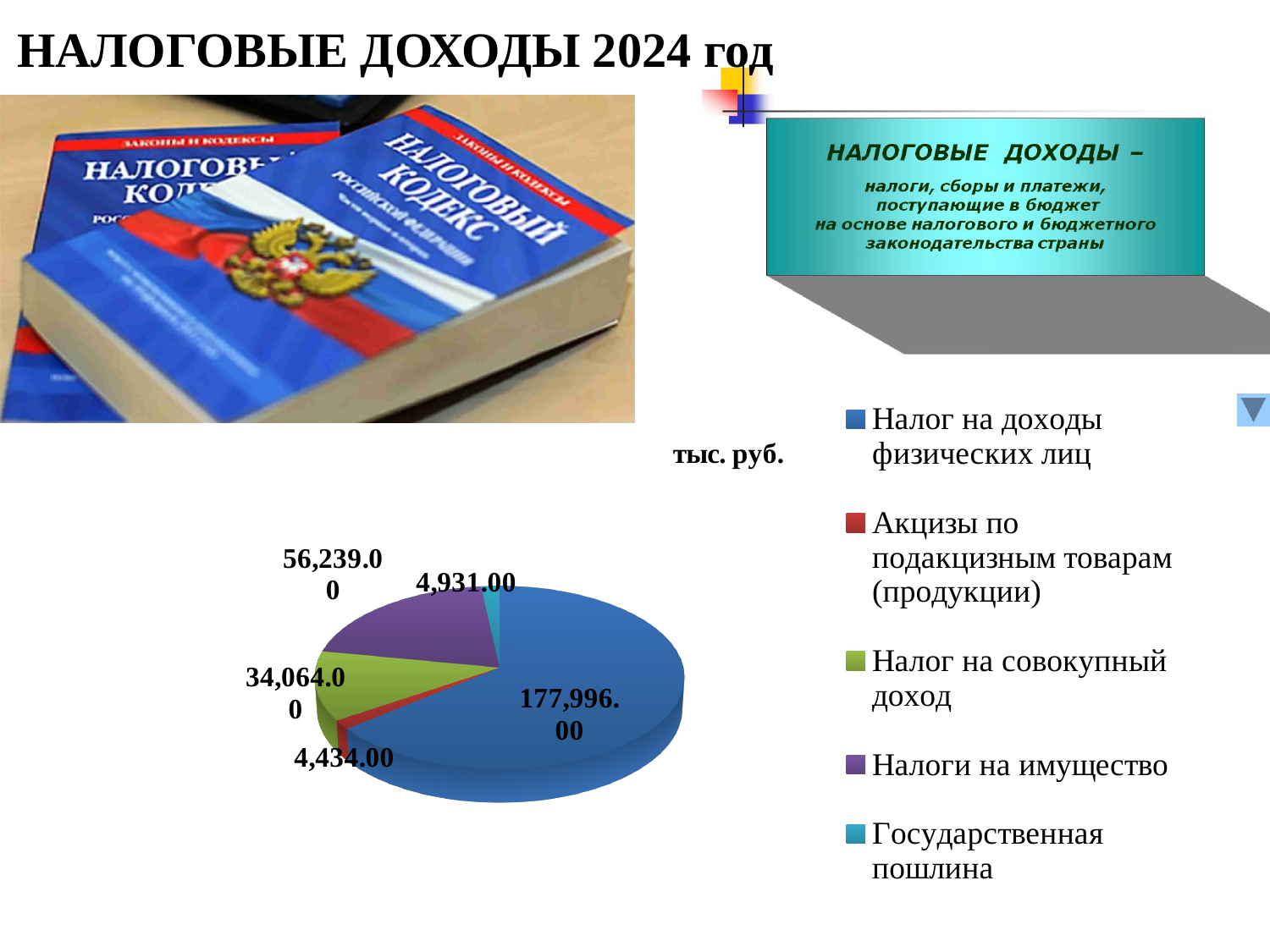
Which is larger: the value for Государственная пошлина or the value for Акцизы по подакцизным товарам (продукции)? Государственная пошлина What type of chart is shown on the slide? pie chart What unit is indicated for the values in the pie chart? тыс. руб. How many entries does the legend of the pie chart list? 5 What is the value for Налоги на имущество in the pie chart? 56,239.00 What is the value for Налог на совокупный доход in the pie chart? 34,064.00 What is the value for Государственная пошлина in the pie chart? 4,931.00 What is the difference between the values for Налоги на имущество and Налог на совокупный доход? 22,175.00 What is the value for Налог на доходы физических лиц in the pie chart? 177,996.00 How many slices does the pie chart have? 5 Which category has the smallest slice in the pie chart? Акцизы по подакцизным товарам (продукции) Which category has the largest slice in the pie chart? Налог на доходы физических лиц